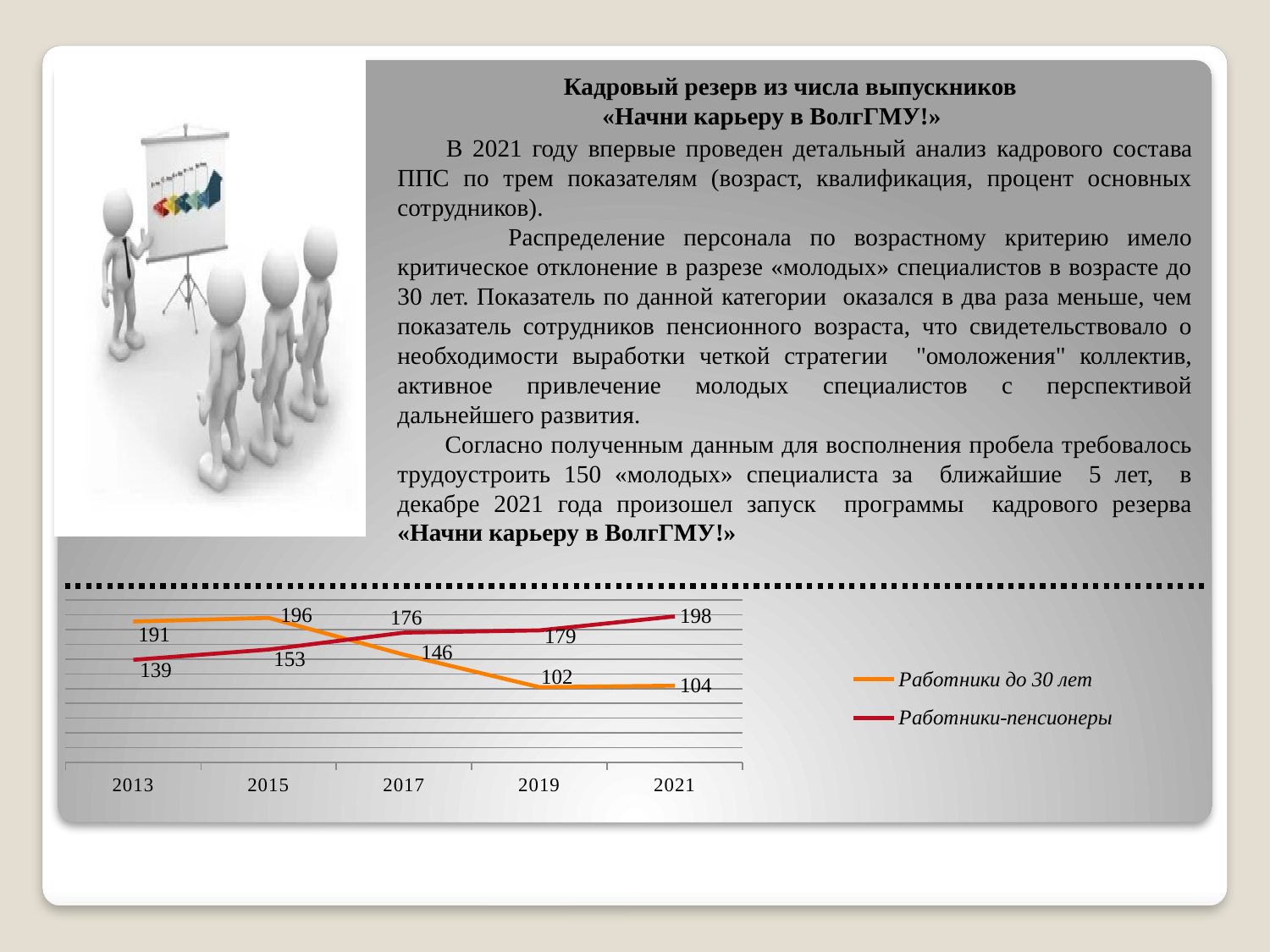
Which colour is used for the Работники до 30 лет line? orange What is the value for Работники-пенсионеры in 2021? 198 Does the value for Работники-пенсионеры rise or fall from 2013 to 2021? rise How many series does the chart legend list? 2 What is the value for Работники до 30 лет in 2013? 191 In which year is the value for Работники до 30 лет highest? 2015 How many years are plotted on the x axis of the chart? 5 What kind of chart is shown on the slide? line chart In which year is the value for Работники-пенсионеры lowest? 2013 What is the value for Работники до 30 лет in 2019? 102 Which series has the larger value in 2017, Работники до 30 лет or Работники-пенсионеры? Работники-пенсионеры What is the difference between Работники-пенсионеры and Работники до 30 лет in 2021? 94